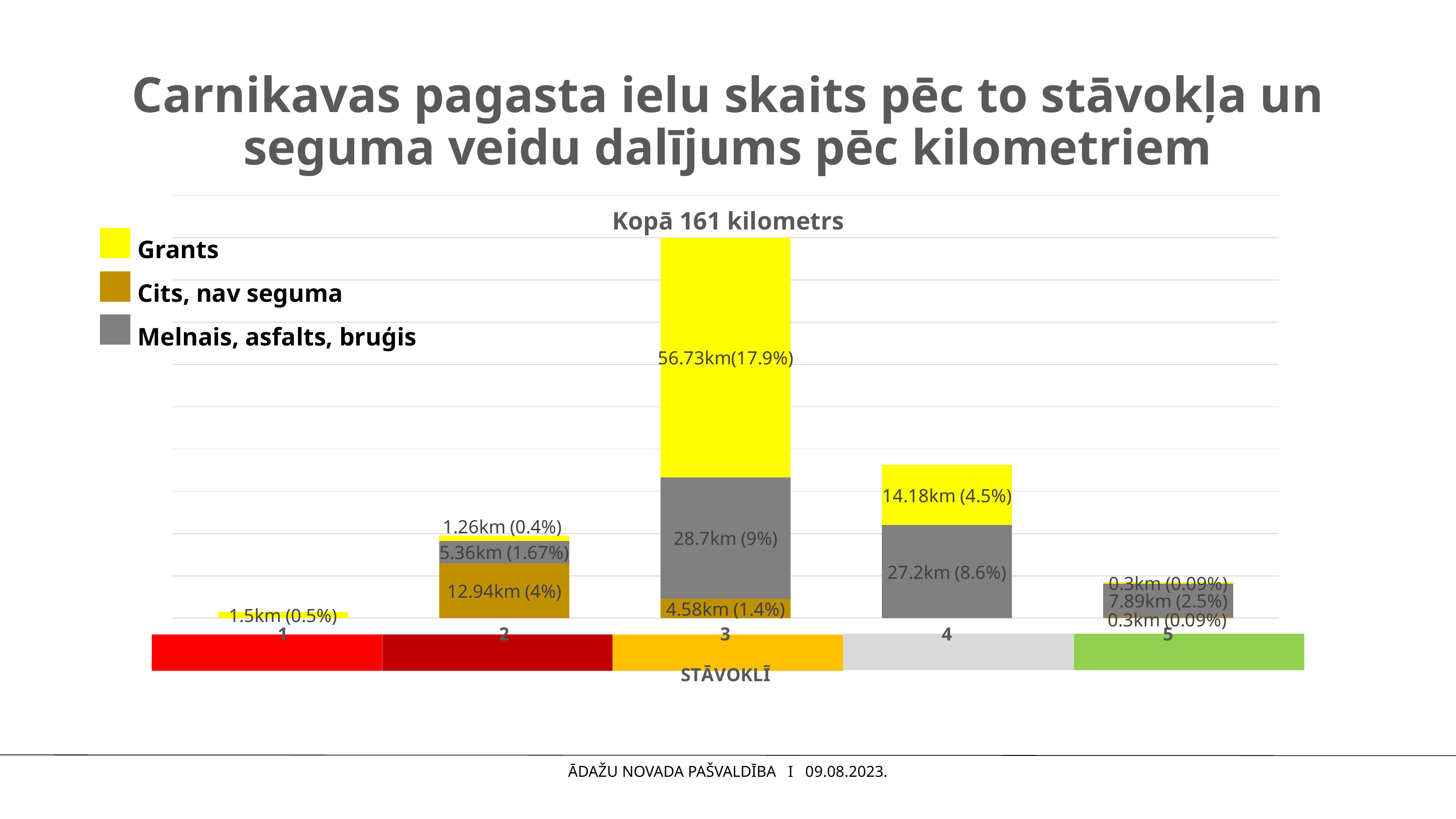
Which is larger: the Melnais, asfalts, bruģis segment of category 3 or of category 4? category 3 What is the value of the Melnais, asfalts, bruģis segment for category 5? 7.89km (2.5%) What is the value of the Cits, nav seguma segment for category 2? 12.94km (4%) What is the value of the Melnais, asfalts, bruģis segment for category 4? 27.2km (8.6%) What is the value of the Grants segment for category 3? 56.73km(17.9%) Which category has the shortest stacked bar? 1 What is the value of the Grants segment for category 1? 1.5km (0.5%) How many categories are shown on the x axis? 5 Which category has the tallest stacked bar? 3 How many series does the legend list? 3 What kind of chart is shown on the slide? stacked bar chart What is the difference in kilometres between the Grants segment of category 3 and the Grants segment of category 4? 42.55km